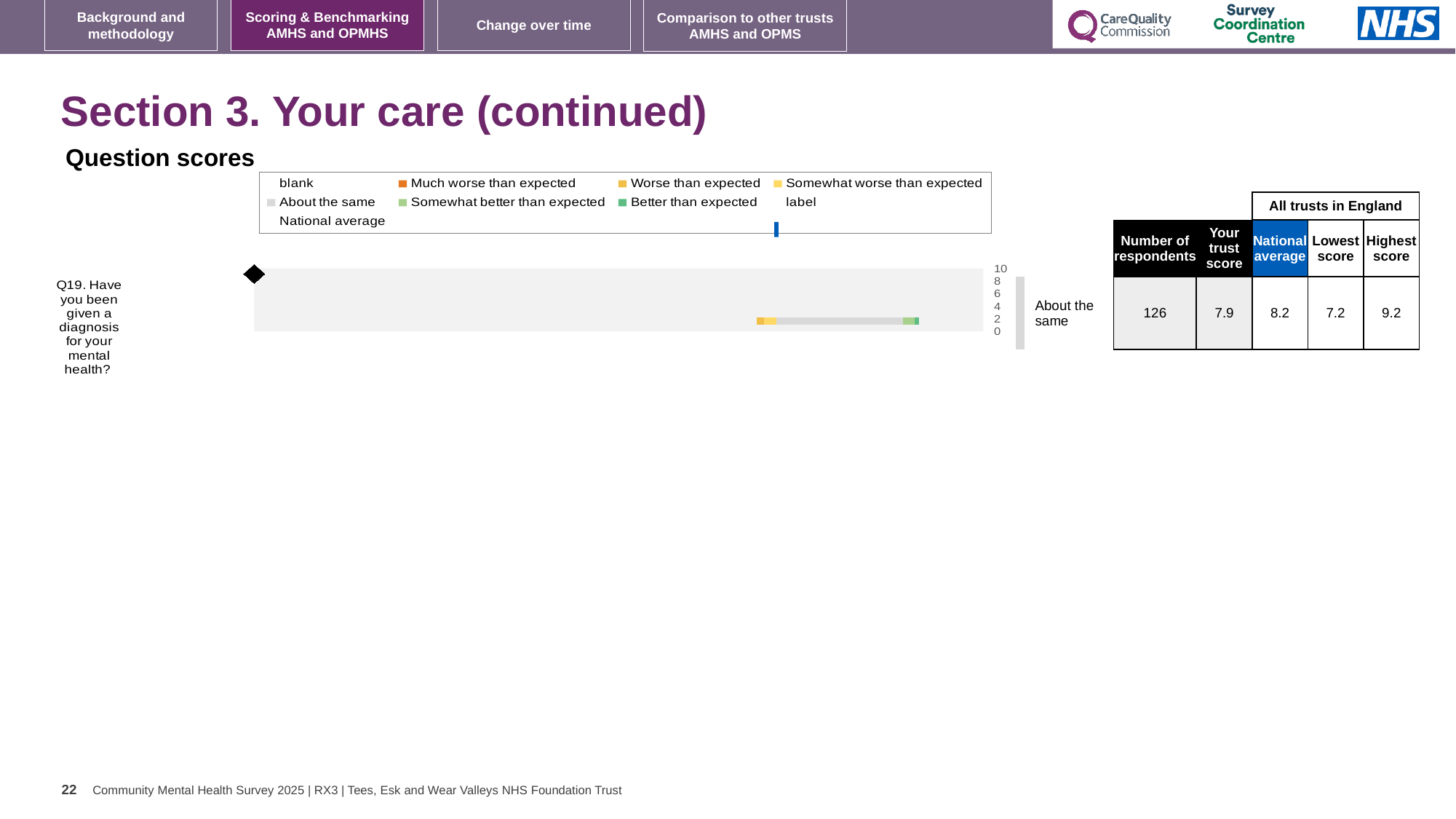
Which question is plotted in the Question scores chart? Q19. Have you been given a diagnosis for your mental health? In the table beside the chart, what is the difference between the highest score and the lowest score for Q19? 2.0 How many questions (categories) are plotted in the Question scores chart? 1 In the table beside the chart, which is larger for Q19: your trust score or the national average? national average In the table beside the chart, what is the highest score among all trusts in England for Q19? 9.2 In the table beside the chart, what is the number of respondents for Q19? 126 In the table beside the chart, what is the national average for Q19? 8.2 In the table beside the chart, what is the lowest score among all trusts in England for Q19? 7.2 What kind of chart is shown under 'Question scores'? bar chart How many entries does the legend of the Question scores chart list? 9 In the table beside the chart, what is 'Your trust score' for Q19? 7.9 What benchmark rating is shown next to the bar for Q19 in the Question scores chart? About the same